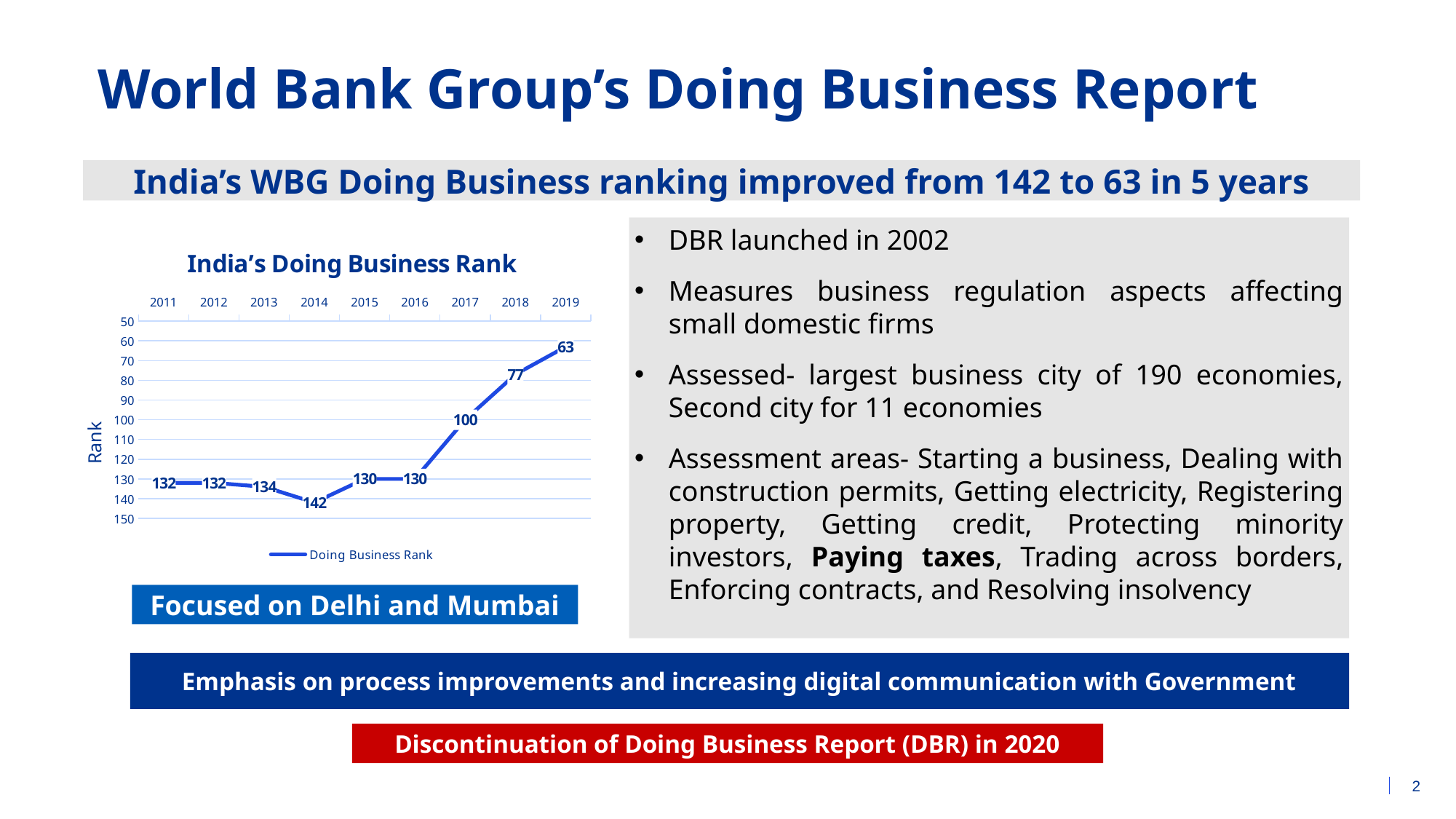
What type of chart is shown on the slide? Line chart How many years are plotted on the chart? 9 What is India's Doing Business Rank for 2017? 100 What is India's Doing Business Rank for 2019? 63 Do the plotted rank values rise or fall from 2014 to 2019? Fall In which year is the plotted rank value the smallest number? 2019 In which year is the plotted rank value the largest number? 2014 What is India's Doing Business Rank for 2014? 142 What is India's Doing Business Rank for 2011? 132 Which year has the larger rank number, 2013 or 2015? 2013 What is the difference between the rank values for 2017 and 2018? 23 What is the difference between the rank values for 2014 and 2019? 79